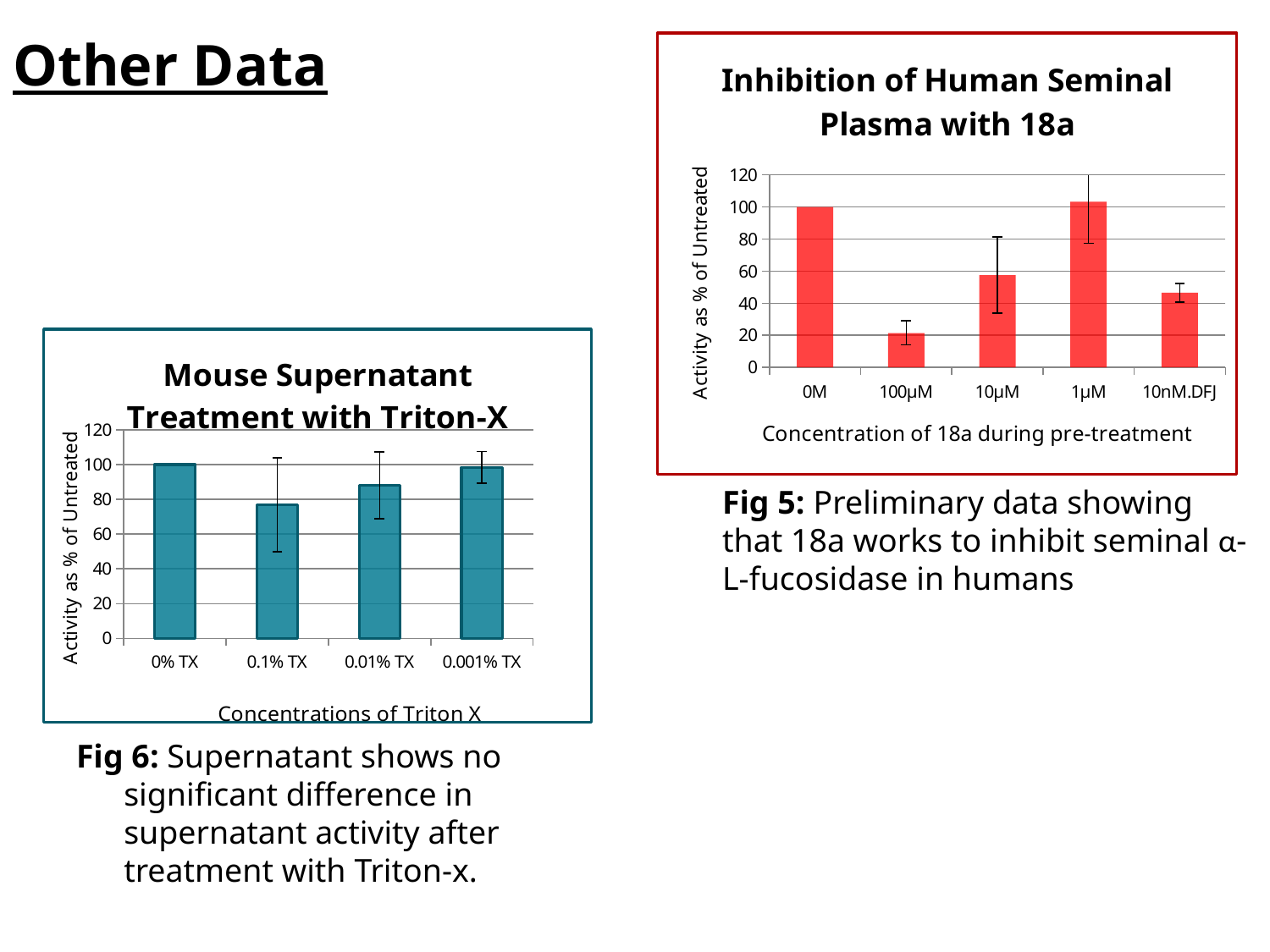
In the 'Inhibition of Human Seminal Plasma with 18a' chart, what is the value for 0M? 100 In the 'Mouse Supernatant Treatment with Triton-X' chart, what is the value for 0% TX? 100 What kind of chart is the 'Mouse Supernatant Treatment with Triton-X' chart? bar chart What is the x-axis title of the 'Mouse Supernatant Treatment with Triton-X' chart? Concentrations of Triton X In the 'Inhibition of Human Seminal Plasma with 18a' chart, which concentration has the lowest activity? 100µM In the 'Inhibition of Human Seminal Plasma with 18a' chart, is the value for 100µM greater or less than 40? less In the 'Inhibition of Human Seminal Plasma with 18a' chart, is the value for 10µM greater or less than 40? greater In the 'Mouse Supernatant Treatment with Triton-X' chart, which concentration has the lowest activity? 0.1% TX In the 'Inhibition of Human Seminal Plasma with 18a' chart, which is larger, the value for 10µM or the value for 100µM? 10µM In the 'Inhibition of Human Seminal Plasma with 18a' chart, is the value for 10nM.DFJ greater or less than 60? less How many concentration categories are shown in the 'Inhibition of Human Seminal Plasma with 18a' chart? 5